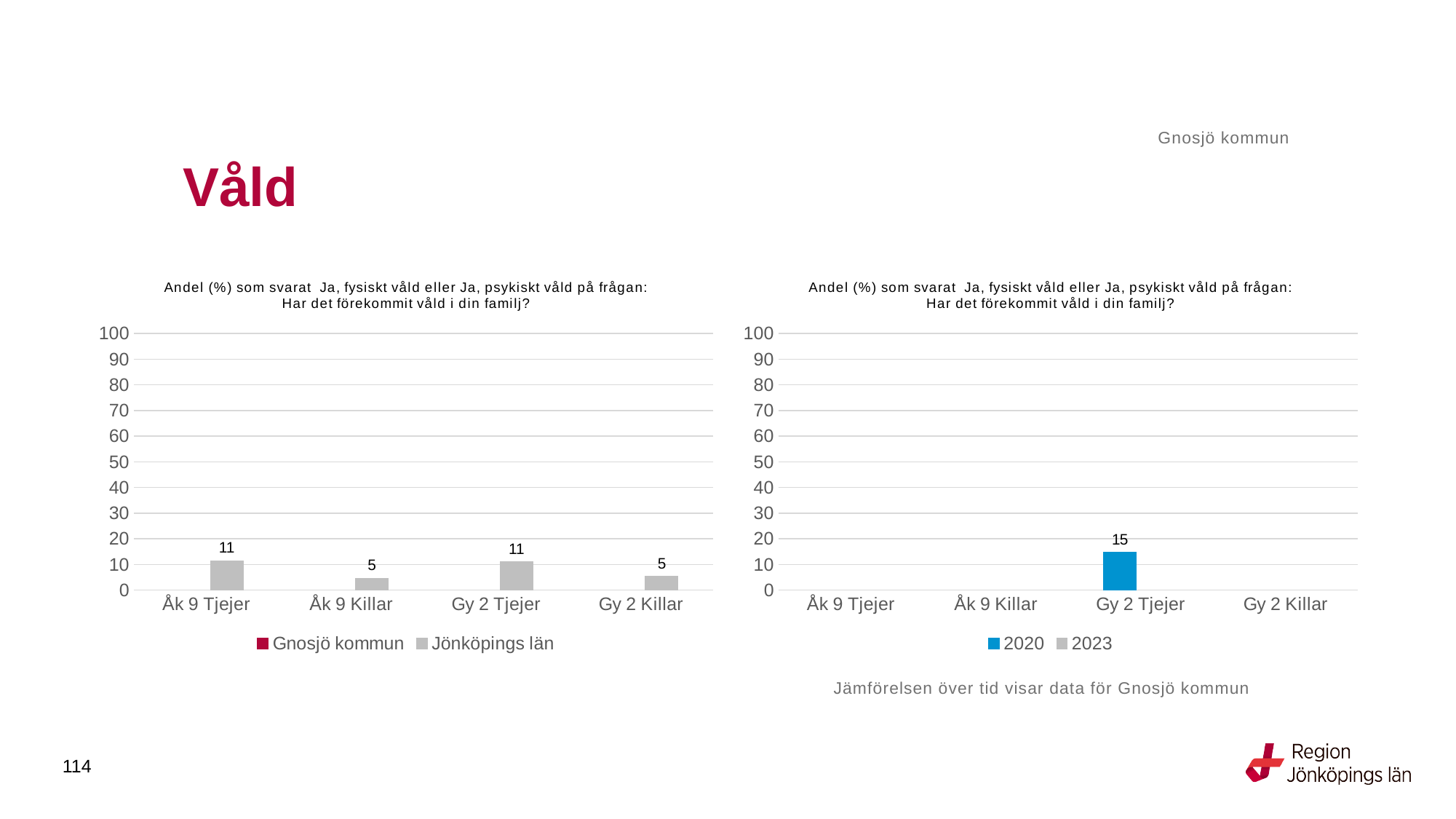
How many categories are shown on the x axis of the left chart? 4 In the left chart, which is larger for Jönköpings län: Gy 2 Tjejer or Gy 2 Killar? Gy 2 Tjejer How many series does the legend of the right chart list? 2 In the left chart, what is the value for Jönköpings län for Gy 2 Tjejer? 11 In the left chart, what is the difference between the Jönköpings län values for Åk 9 Tjejer and Åk 9 Killar? 6 In the left chart, what is the value for Jönköpings län for Gy 2 Killar? 5 What kind of chart is the left chart? bar chart In the right chart, is the value for 2020 for Gy 2 Tjejer greater or less than 20? less In the right chart, which category has the highest value for 2020? Gy 2 Tjejer What are the two series listed in the legend of the left chart? Gnosjö kommun and Jönköpings län In the left chart, what is the value for Jönköpings län for Åk 9 Killar? 5 In the right chart, what is the value for 2020 for Gy 2 Tjejer? 15